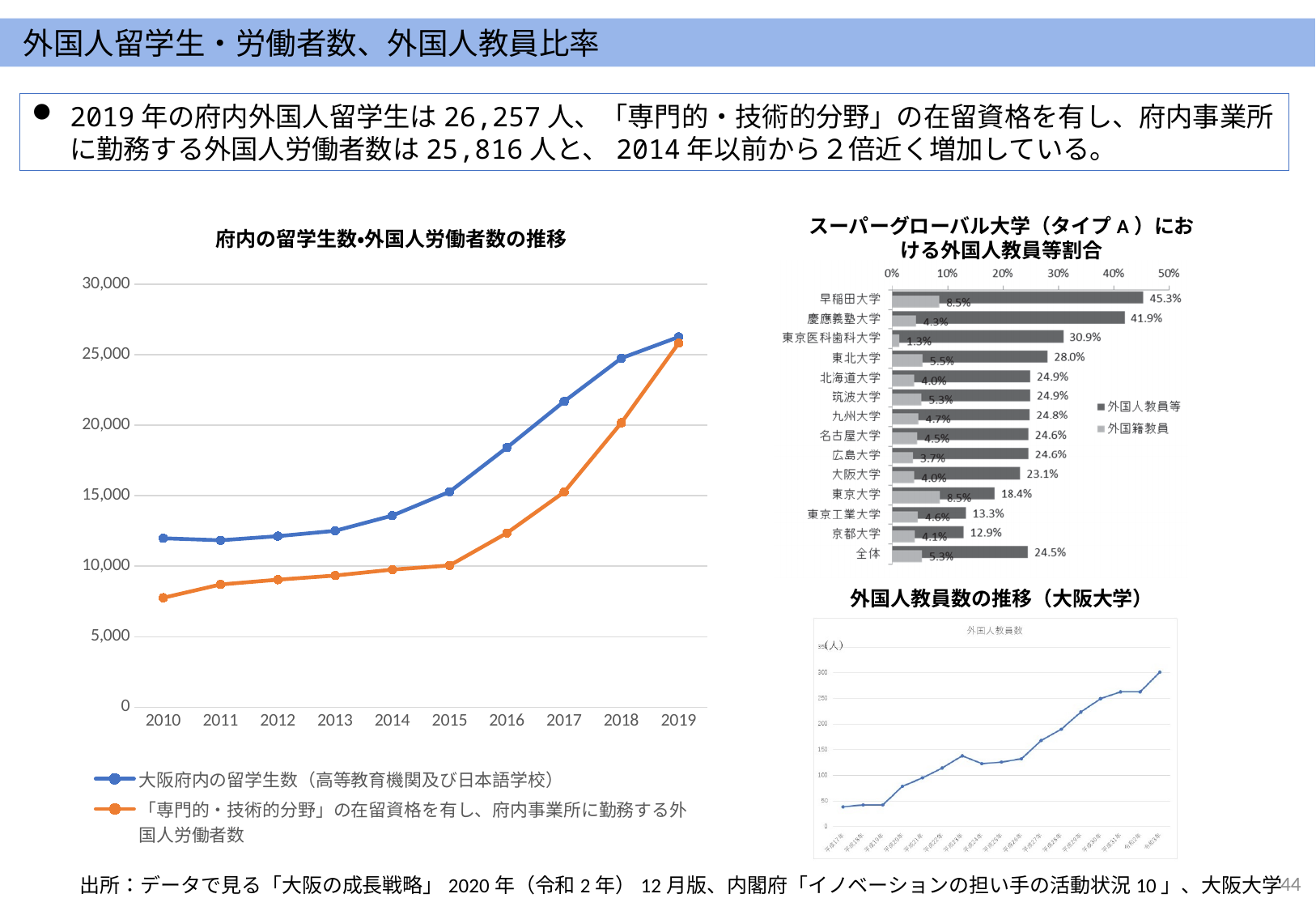
In the chart titled スーパーグローバル大学（タイプA）における外国人教員等割合, how many series does the legend list? 2 In the chart titled スーパーグローバル大学（タイプA）における外国人教員等割合, what is the difference between the 外国人教員等 values for 早稲田大学 and 慶應義塾大学? 3.4% In the chart titled スーパーグローバル大学（タイプA）における外国人教員等割合, which is larger: the 外国人教員等 value for 大阪大学 or for 東京大学? 大阪大学 What kind of chart is the one titled スーパーグローバル大学（タイプA）における外国人教員等割合? bar chart In the chart titled スーパーグローバル大学（タイプA）における外国人教員等割合, what is the 外国人教員等 value for 早稲田大学? 45.3% In the chart titled スーパーグローバル大学（タイプA）における外国人教員等割合, what is the 外国籍教員 value for 東京医科歯科大学? 1.3% In the chart titled 府内の留学生数•外国人労働者数の推移, does the 外国人労働者数 series rise or fall from 2010 to 2019? rise In the chart titled スーパーグローバル大学（タイプA）における外国人教員等割合, which university has the highest 外国人教員等 value? 早稲田大学 In the chart titled スーパーグローバル大学（タイプA）における外国人教員等割合, how many categories (rows) are shown? 14 What kind of chart is the one titled 府内の留学生数•外国人労働者数の推移? line chart In the chart titled スーパーグローバル大学（タイプA）における外国人教員等割合, which university has the lowest 外国人教員等 value? 京都大学